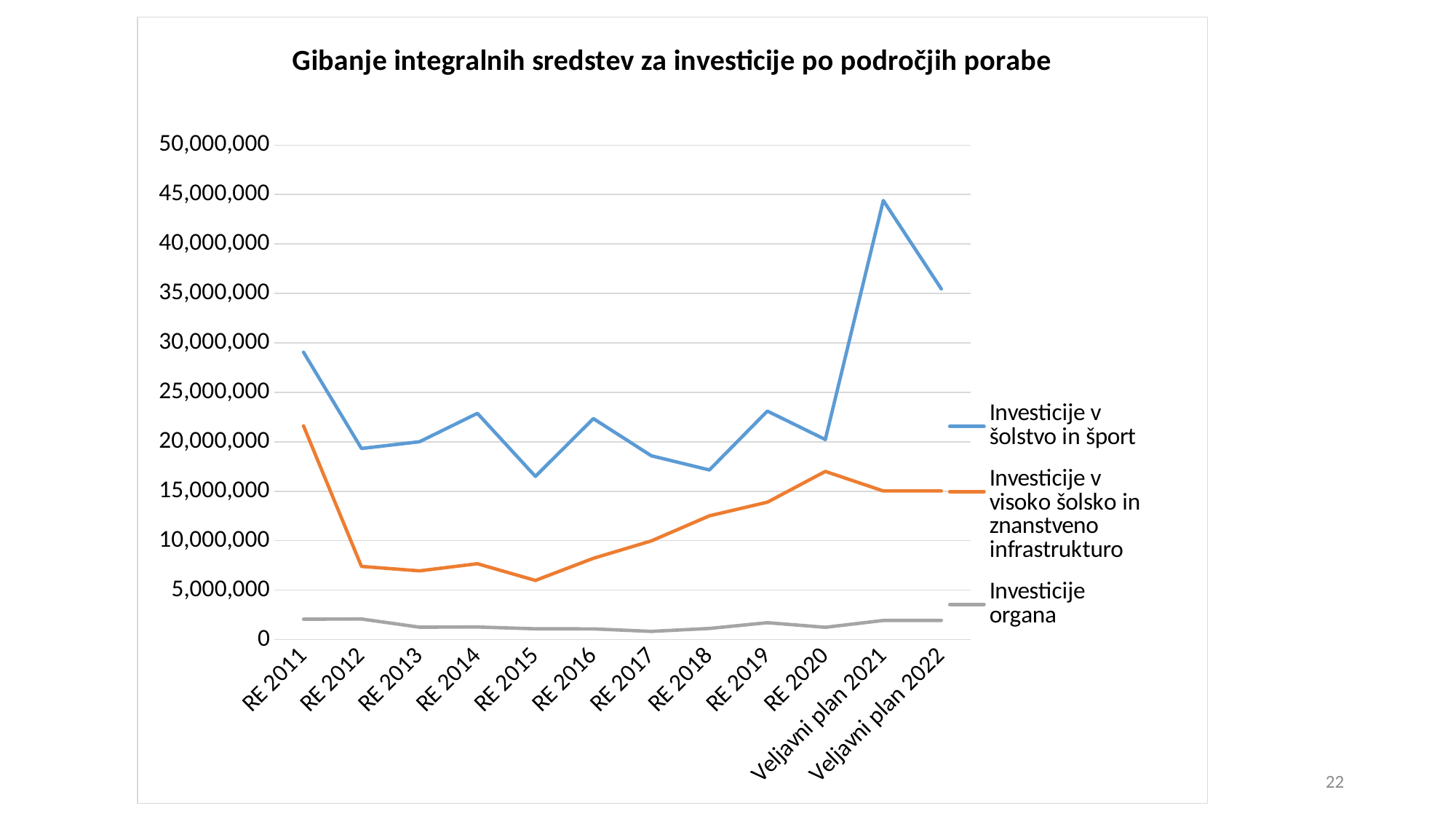
What kind of chart is shown on the slide? line chart For 'Investicije v visoko šolsko in znanstveno infrastrukturo', does the value rise or fall from RE 2015 to RE 2020? rise At RE 2011, which series has the larger value: 'Investicije v šolstvo in šport' or 'Investicije v visoko šolsko in znanstveno infrastrukturo'? Investicije v šolstvo in šport In which category does the series 'Investicije v visoko šolsko in znanstveno infrastrukturo' reach its highest value? RE 2011 Is the value for 'Investicije v šolstvo in šport' at RE 2015 greater or less than 20,000,000? less How many categories are shown on the x axis? 12 What is the title of the chart? Gibanje integralnih sredstev za investicije po področjih porabe Is the value for 'Investicije organa' at RE 2011 greater or less than 5,000,000? less Is the value for 'Investicije v šolstvo in šport' at Veljavni plan 2021 greater or less than 40,000,000? greater How many series does the legend list? 3 In which category does the series 'Investicije v šolstvo in šport' reach its highest value? Veljavni plan 2021